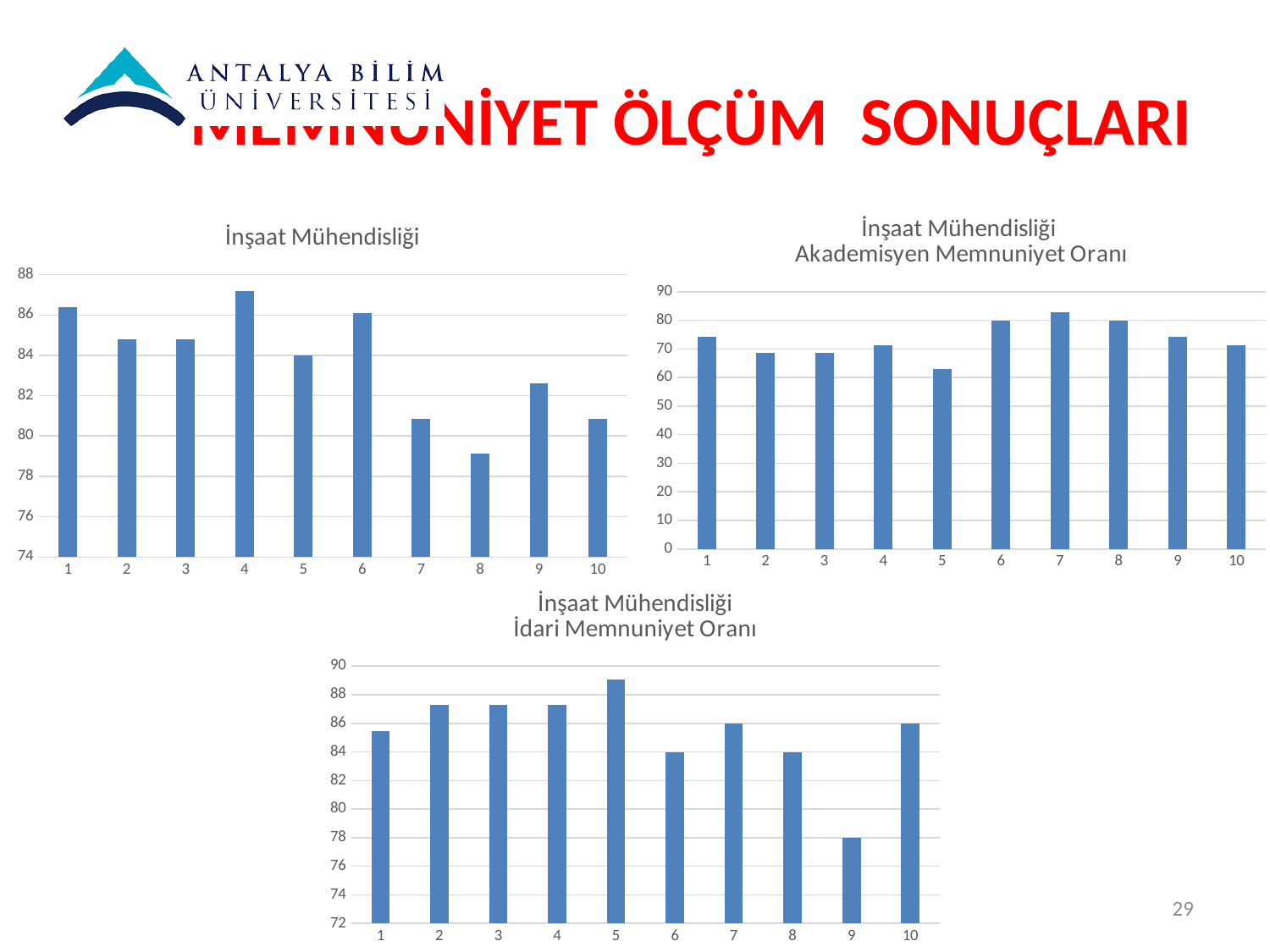
In the top-left chart titled 'İnşaat Mühendisliği', is the value for category 1 greater or less than 86? greater In the chart titled 'İnşaat Mühendisliği İdari Memnuniyet Oranı', which category has the lowest value? 9 In the chart titled 'İnşaat Mühendisliği Akademisyen Memnuniyet Oranı', which category has the highest value? 7 In the chart titled 'İnşaat Mühendisliği İdari Memnuniyet Oranı', is the value for category 9 greater or less than 80? less In the top-left chart titled 'İnşaat Mühendisliği', is the value for category 8 greater or less than 80? less In the chart titled 'İnşaat Mühendisliği Akademisyen Memnuniyet Oranı', which is larger, the value for category 1 or category 2? category 1 In the chart titled 'İnşaat Mühendisliği İdari Memmuniyet Oranı', which category has the highest value? 5 How many categories are shown on the x axis of the chart titled 'İnşaat Mühendisliği İdari Memnuniyet Oranı'? 10 In the top-left chart titled 'İnşaat Mühendisliği', which category has the highest value? 4 In the top-left chart titled 'İnşaat Mühendisliği', which category has the lowest value? 8 In the chart titled 'İnşaat Mühendisliği Akademisyen Memnuniyet Oranı', which category has the lowest value? 5